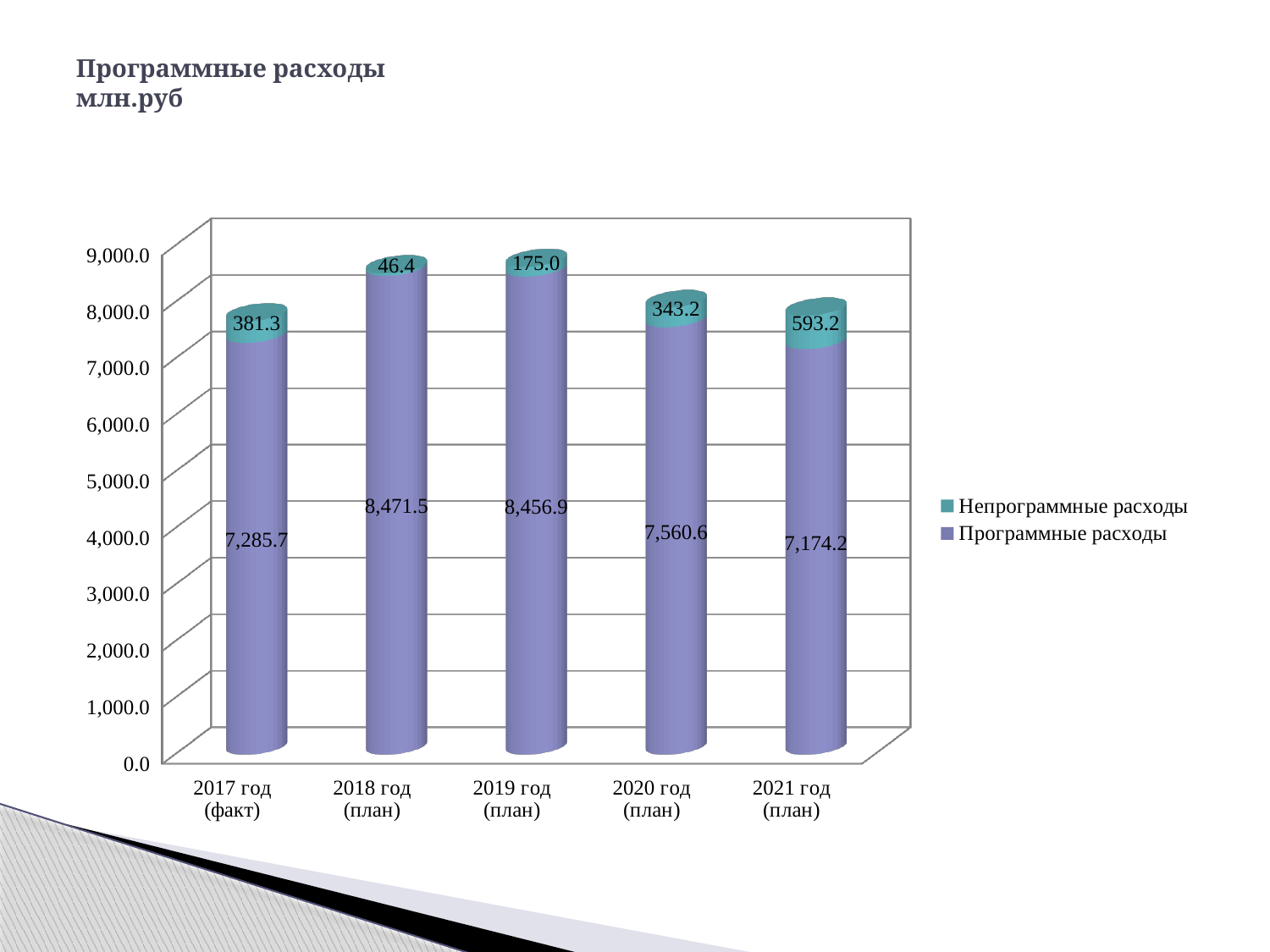
Which year has the lowest value of Непрограммные расходы? 2018 год (план) Which year has the highest value of Программные расходы? 2018 год (план) How many series does the legend list? 2 How many year categories are shown on the x axis? 5 What is the value of Непрограммные расходы for 2021 год (план)? 593.2 What is the total of the stacked bar for 2017 год (факт)? 7,667.0 What is the value of Непрограммные расходы for 2017 год (факт)? 381.3 What is the difference between Программные расходы in 2020 год (план) and 2021 год (план)? 386.4 What is the value of Программные расходы for 2018 год (план)? 8,471.5 Which series is shown in teal in the legend? Непрограммные расходы Which is larger: Непрограммные расходы in 2019 год (план) or in 2020 год (план)? 2020 год (план) What kind of chart is shown on the slide? Stacked bar chart